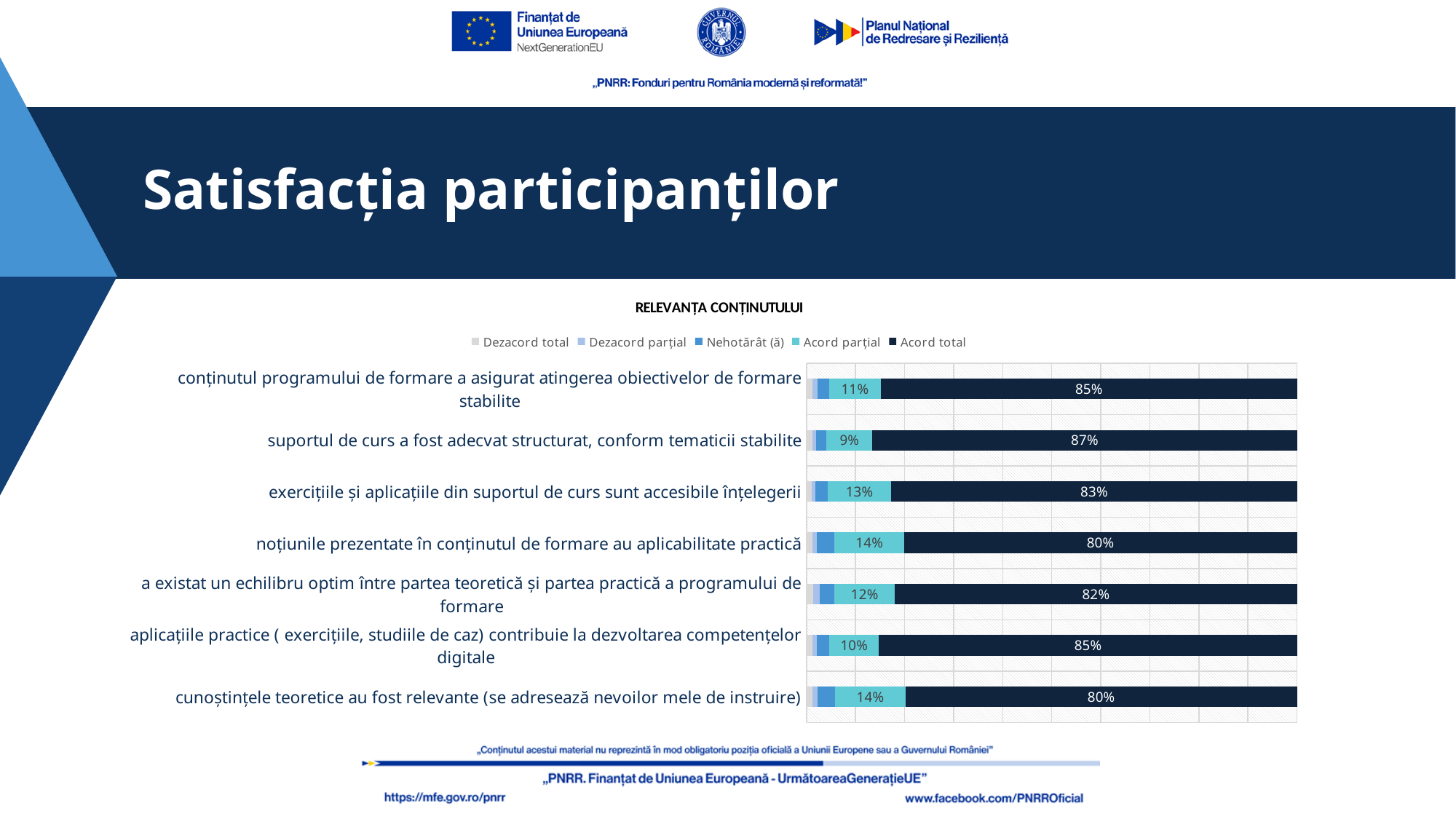
What is the title of the chart? RELEVANȚA CONȚINUTULUI How many series does the chart legend list? 5 What is the 'Acord parțial' value for 'aplicațiile practice ( exercițiile, studiile de caz) contribuie la dezvoltarea competențelor digitale'? 10% What is the 'Acord total' value for 'noțiunile prezentate în conținutul de formare au aplicabilitate practică'? 80% What is the 'Acord parțial' value for 'exercițiile și aplicațiile din suportul de curs sunt accesibile înțelegerii'? 13% Which is larger: the 'Acord total' value for 'exercițiile și aplicațiile din suportul de curs sunt accesibile înțelegerii' or for 'a existat un echilibru optim între partea teoretică și partea practică a programului de formare'? exercițiile și aplicațiile din suportul de curs sunt accesibile înțelegerii What kind of chart is shown on the slide? Stacked bar chart What is the 'Acord total' value for 'suportul de curs a fost adecvat structurat, conform tematicii stabilite'? 87% Which statement has the lowest 'Acord parțial' value? suportul de curs a fost adecvat structurat, conform tematicii stabilite What is the difference between the 'Acord total' values for 'suportul de curs a fost adecvat structurat, conform tematicii stabilite' and 'cunoștințele teoretice au fost relevante (se adresează nevoilor mele de instruire)'? 7% How many categories (statements) are plotted in the chart? 7 Which statement has the highest 'Acord total' value? suportul de curs a fost adecvat structurat, conform tematicii stabilite